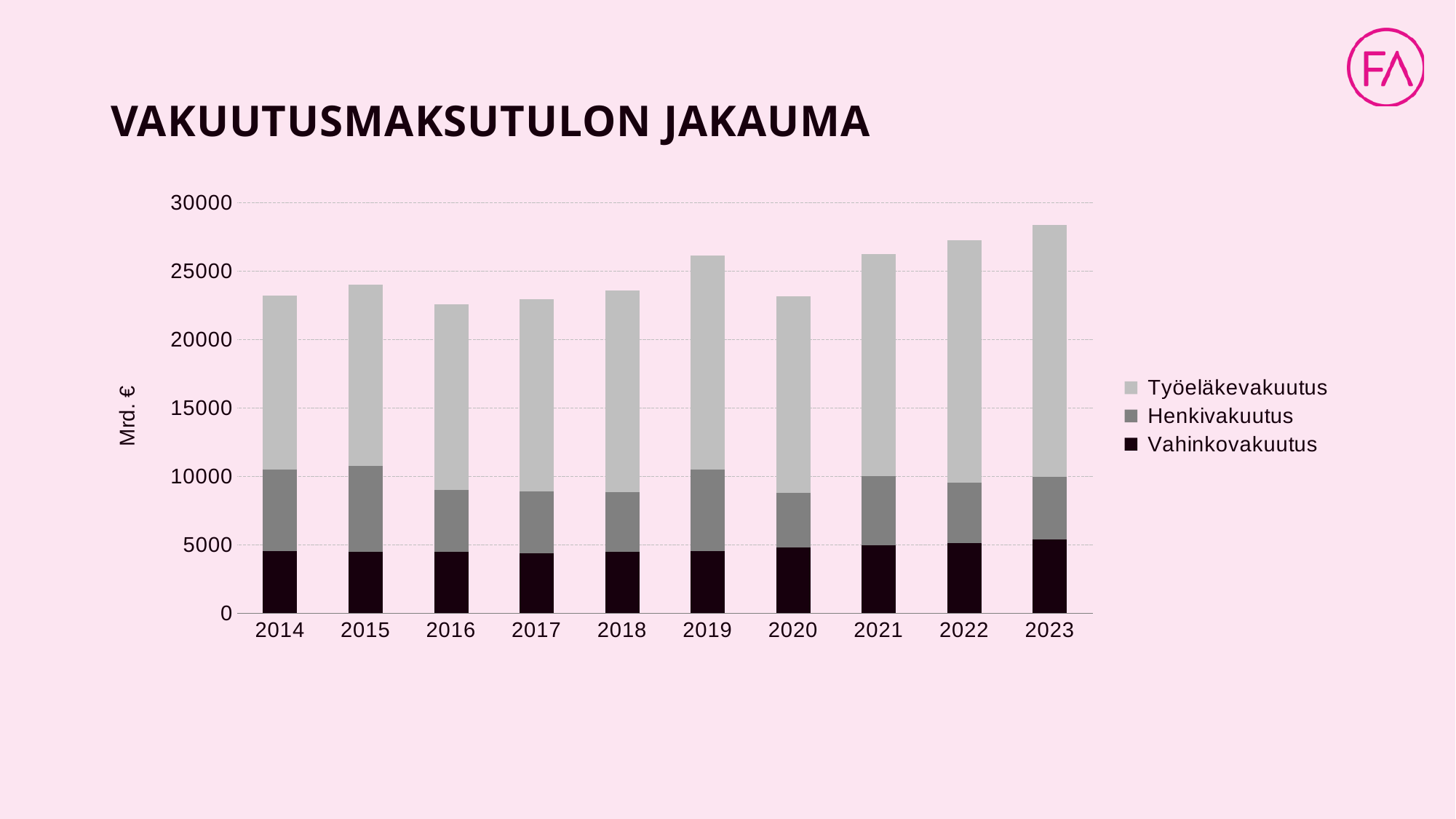
Is the Vahinkovakuutus value for 2023 greater or less than 5000? greater What is the label on the y axis of the chart? Mrd. € Is the total stacked bar for 2019 greater or less than 25000? greater Is the Vahinkovakuutus value for 2014 greater or less than 5000? less How many series does the chart's legend list? 3 Which year has the highest total stacked bar? 2023 What kind of chart is shown on the slide? Stacked bar chart Do the total stacked bars rise or fall from 2020 to 2023? rise What is the title of the chart on the slide? VAKUUTUSMAKSUTULON JAKAUMA How many years are shown on the x axis of the chart? 10